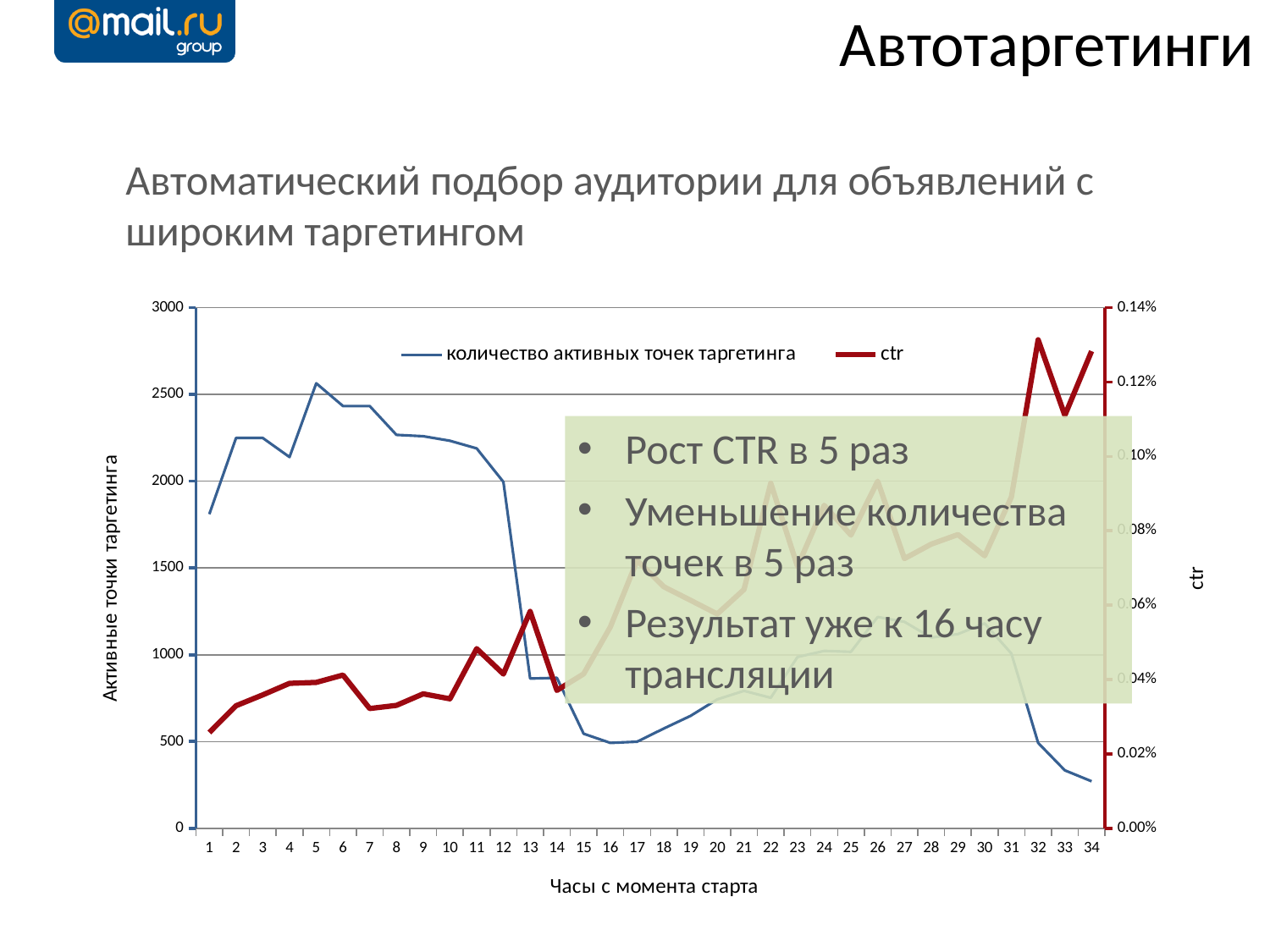
What kind of chart is shown on the slide? line chart Is the value of 'количество активных точек таргетинга' at hour 34 greater or less than 500? less How many series does the chart legend list? 2 What is the title of the x axis of the chart? Часы с момента старта Is the ctr value at hour 1 greater or less than 0.04%? less Does the 'количество активных точек таргетинга' series overall rise or fall from hour 1 to hour 34? fall Is the value of 'количество активных точек таргетинга' at hour 5 greater or less than 2000? greater Which is larger: the ctr value at hour 32 or at hour 1? hour 32 What is the title of the left vertical axis of the chart? Активные точки таргетинга At which hour does 'количество активных точек таргетинга' reach its highest value? 5 How many hours (points) are plotted along the x axis of the chart? 34